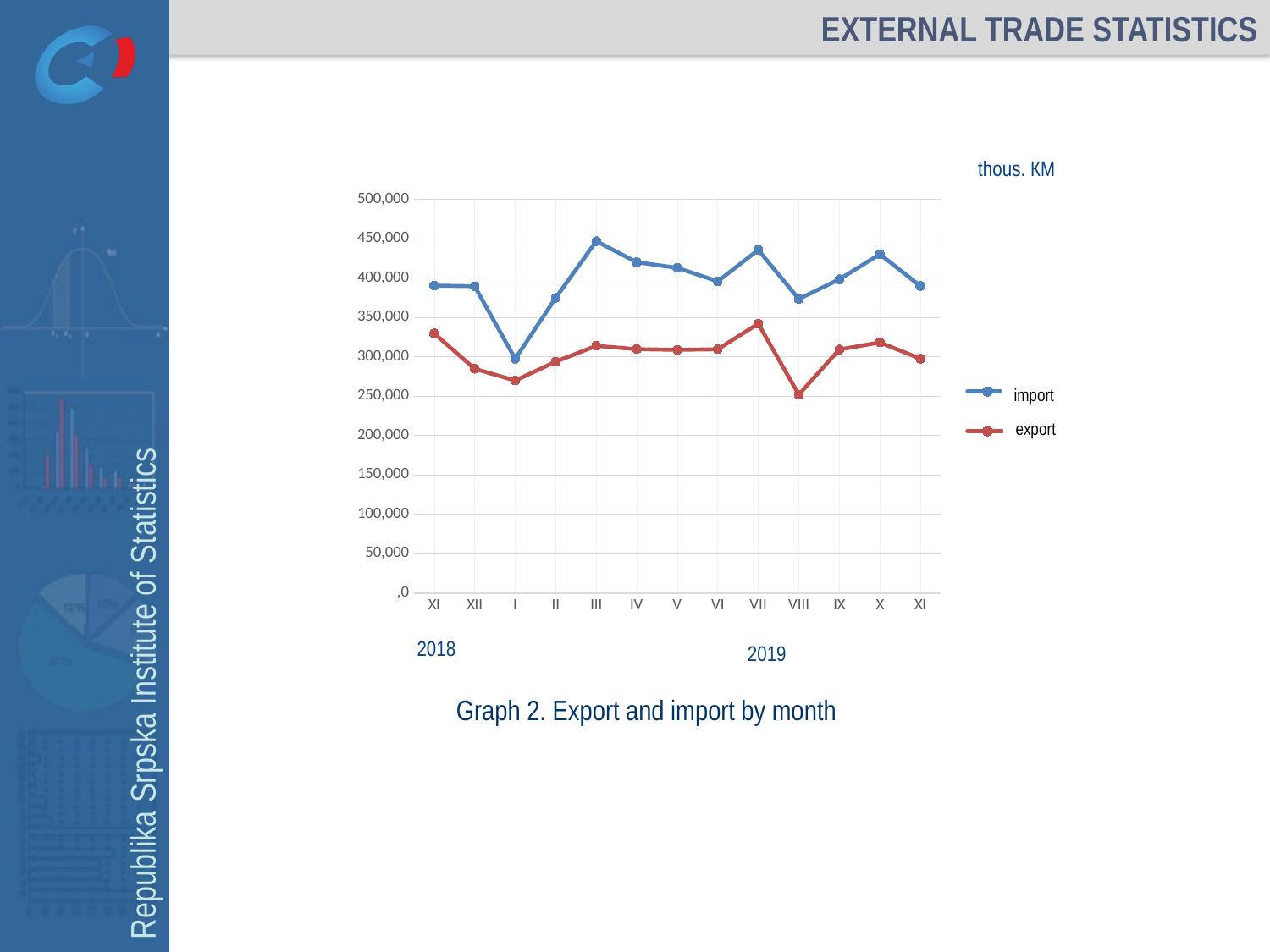
Is the export value for VII 2019 greater or less than 300,000? greater In which month is the export value lowest? VIII 2019 Is the export value for VIII 2019 greater or less than 300,000? less How many series does the legend list? 2 Which is larger in VII 2019, import or export? import In which month is the import value lowest? I 2019 How many monthly points are plotted along the x axis? 13 In what unit are the values on the chart expressed? thous. KM What kind of chart is shown on the slide? line chart What is the title of the chart? Graph 2. Export and import by month In which month is the export value highest? VII 2019 Is the import value for III 2019 greater or less than 400,000? greater